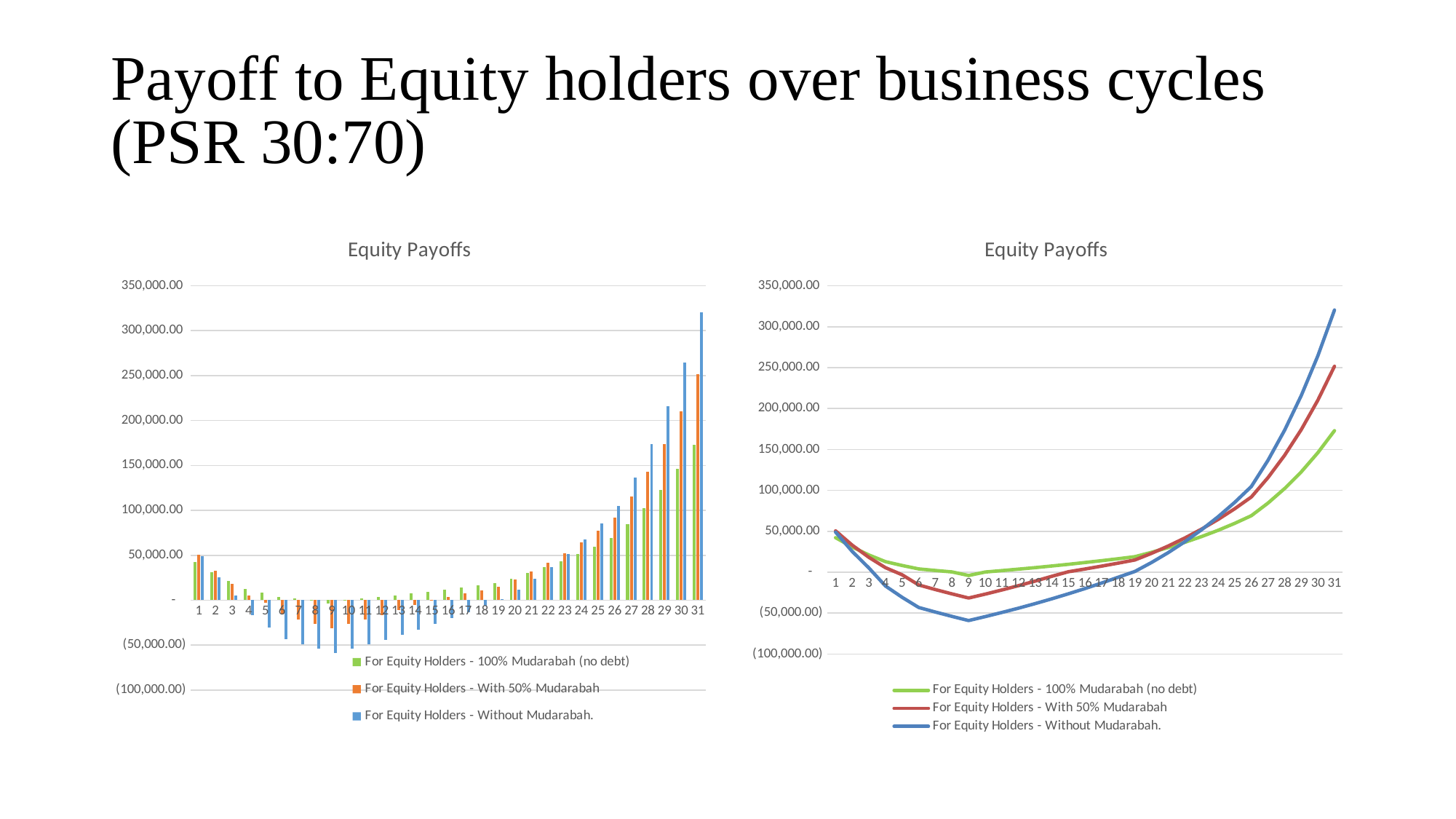
How many periods are shown on the x axis of the right chart? 31 What kind of chart is the right chart on the slide? line chart In the left chart, at period 31, which series has the larger value: 'For Equity Holders - Without Mudarabah.' or 'For Equity Holders - 100% Mudarabah (no debt)'? For Equity Holders - Without Mudarabah. How many series does the legend of the left chart list? 3 In the left chart, is the value for 'For Equity Holders - Without Mudarabah.' at period 31 greater or less than 300,000.00? greater In the right chart, is the value for 'For Equity Holders - Without Mudarabah.' at period 9 greater or less than (50,000.00)? less In the right chart, do the values of the 'For Equity Holders - With 50% Mudarabah' line rise or fall from period 20 to period 31? rise In the right chart, at which period does the 'For Equity Holders - Without Mudarabah.' line reach its highest value? 31 In the right chart, at which period does the 'For Equity Holders - Without Mudarabah.' line reach its lowest value? 9 What kind of chart is the left chart on the slide? bar chart In the right chart, is the value for 'For Equity Holders - 100% Mudarabah (no debt)' at period 31 greater or less than 150,000.00? greater What is the title of the right chart? Equity Payoffs